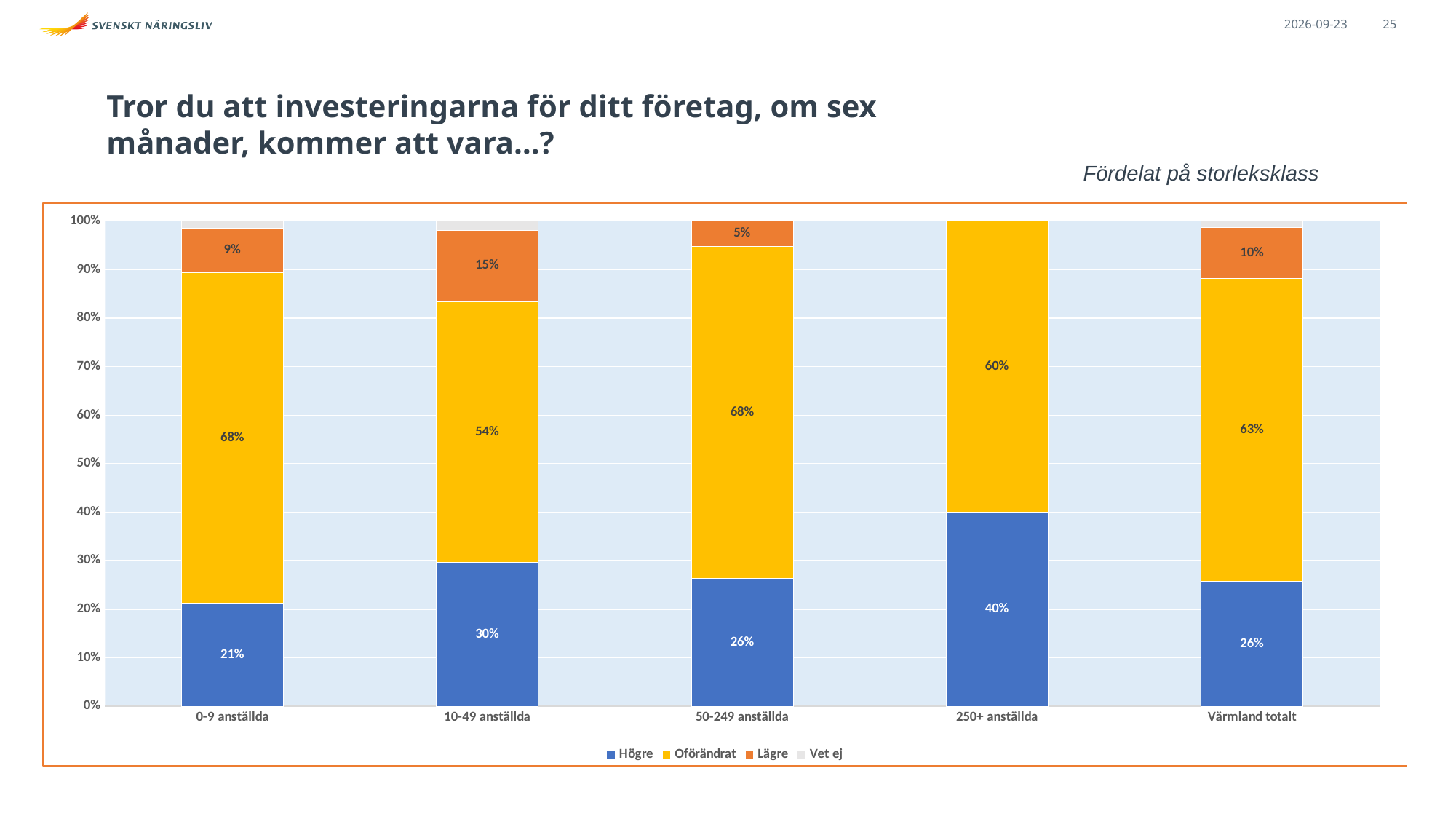
How many size classes (categories) are shown on the x axis? 5 Which size class has the highest Lägre share? 10-49 anställda Is the Oförändrat value larger for 0-9 anställda or for 10-49 anställda? 0-9 anställda What is the difference between the Högre value for 250+ anställda and for 0-9 anställda? 19 percentage points What kind of chart is shown on the slide? Stacked bar chart Which series is shown in yellow in the legend? Oförändrat What is the Lägre value for Värmland totalt? 10% Which size class has the highest Högre share? 250+ anställda How many series does the legend list? 4 What is the Oförändrat value for 10-49 anställda? 54% Which size class has the lowest Högre share? 0-9 anställda What is the Högre value for 250+ anställda? 40%